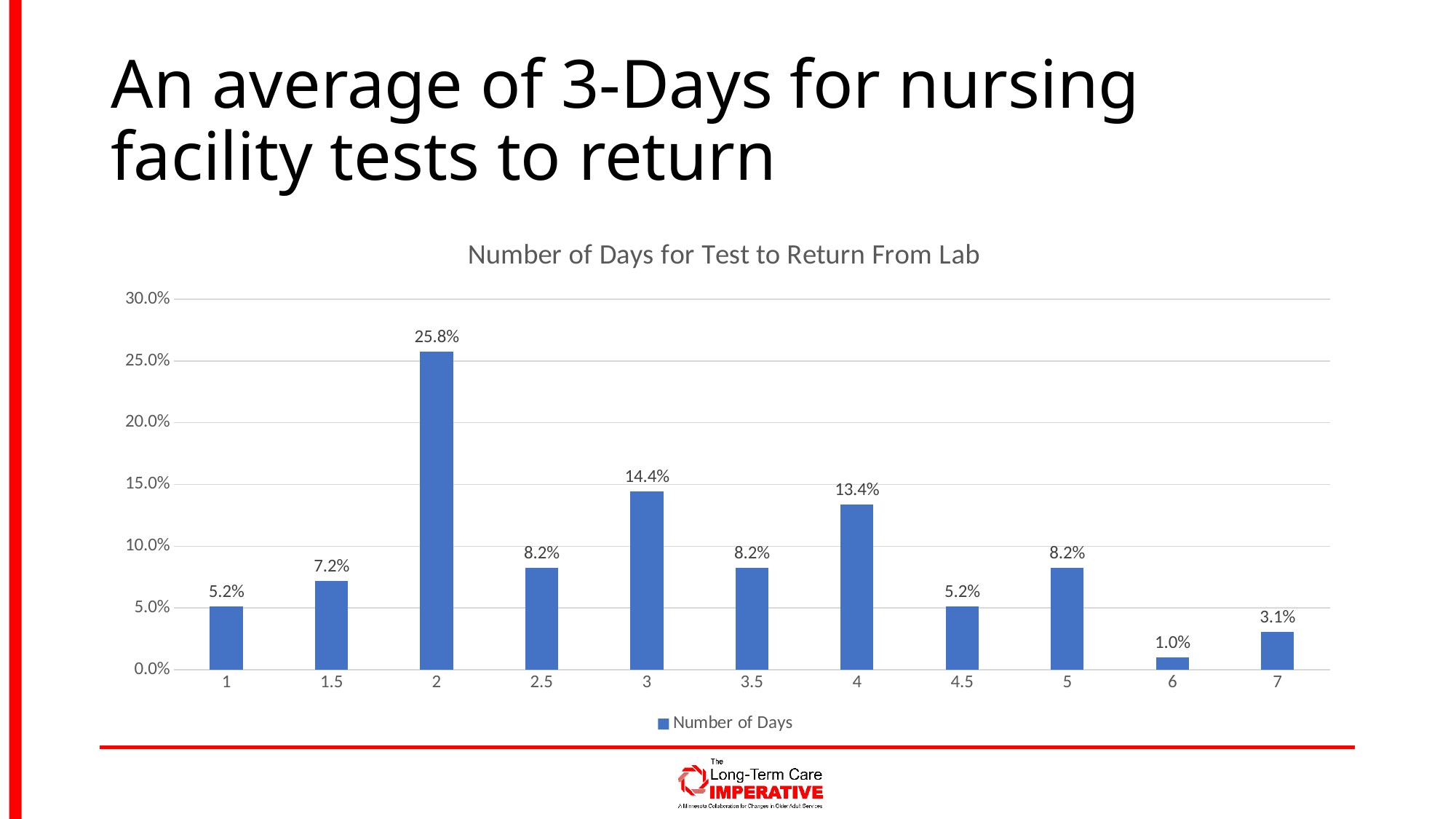
What is the difference between the values for 3 days and 4 days? 1.0% How many series does the legend list? 1 How many categories are shown on the x axis? 11 Which category has the highest value? 2 Which category has the lowest value? 6 What is the value for 2 days in the chart? 25.8% What is the value for 4 days in the chart? 13.4% What kind of chart is shown on the slide? Bar chart What is the value for 7 days in the chart? 3.1% Which is larger, the value for 1.5 days or the value for 4.5 days? 1.5 Is the value for 2 days greater or less than 20.0%? greater What is the title of the chart? Number of Days for Test to Return From Lab